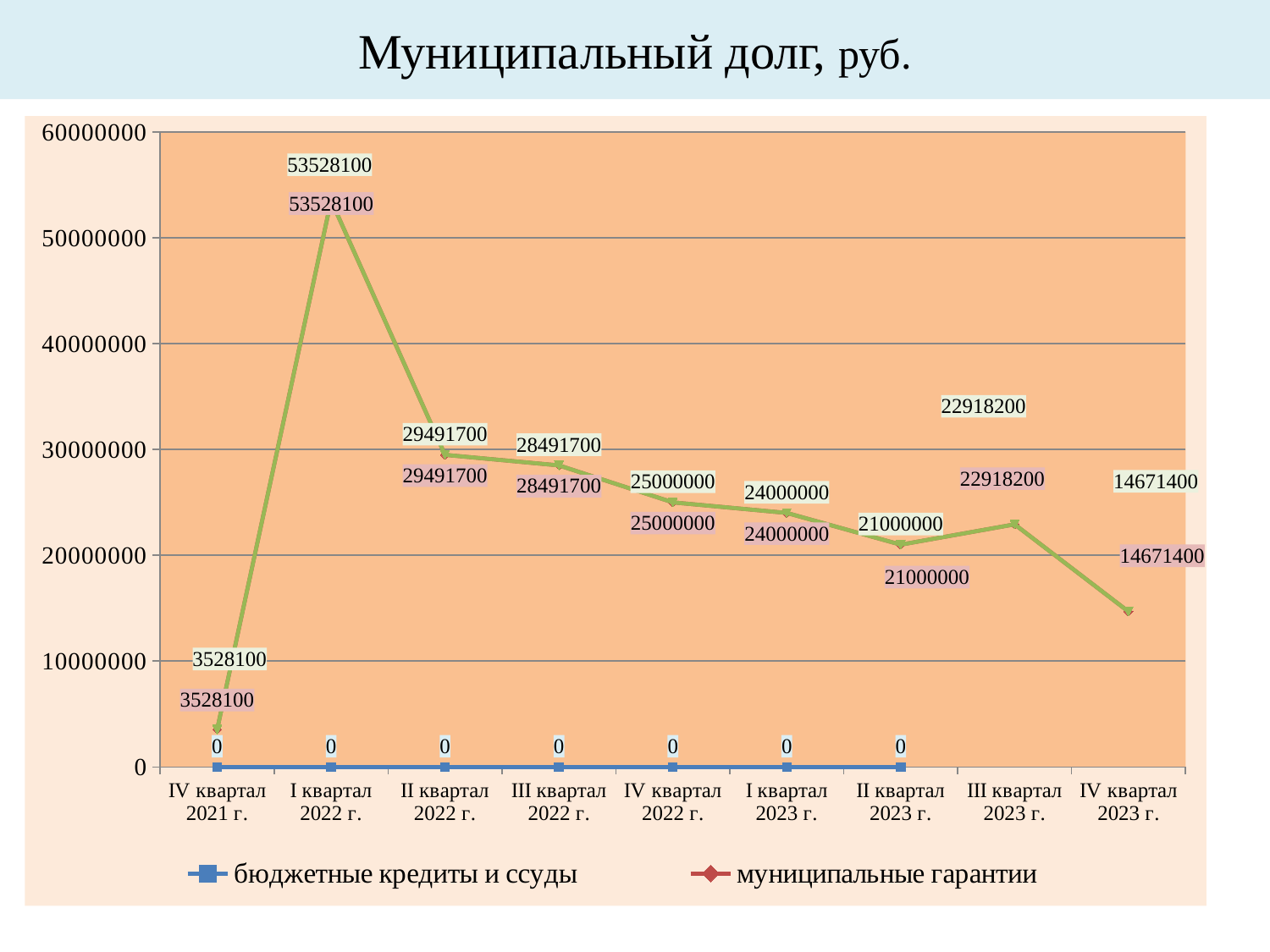
What value is labelled for IV квартал 2023 г. on the upper (green) line? 14671400 What is the difference between the labelled values for I квартал 2022 г. and II квартал 2022 г. on the upper (green) line? 24036400 In which quarter does the upper (green) line reach its highest value? I квартал 2022 г. What value is labelled for I квартал 2022 г. on the upper (green) line? 53528100 What value is labelled for the series 'бюджетные кредиты и ссуды' in II квартал 2023 г.? 0 In which quarter does the upper (green) line have its lowest value? IV квартал 2021 г. How many series does the legend list? 2 What is the title of the chart? Муниципальный долг, руб. Which is larger on the upper (green) line: the value for III квартал 2023 г. or IV квартал 2023 г.? III квартал 2023 г. How many quarters are shown along the x axis? 9 Does the upper (green) line rise or fall from II квартал 2022 г. to II квартал 2023 г.? fall What type of chart is shown on the slide? line chart